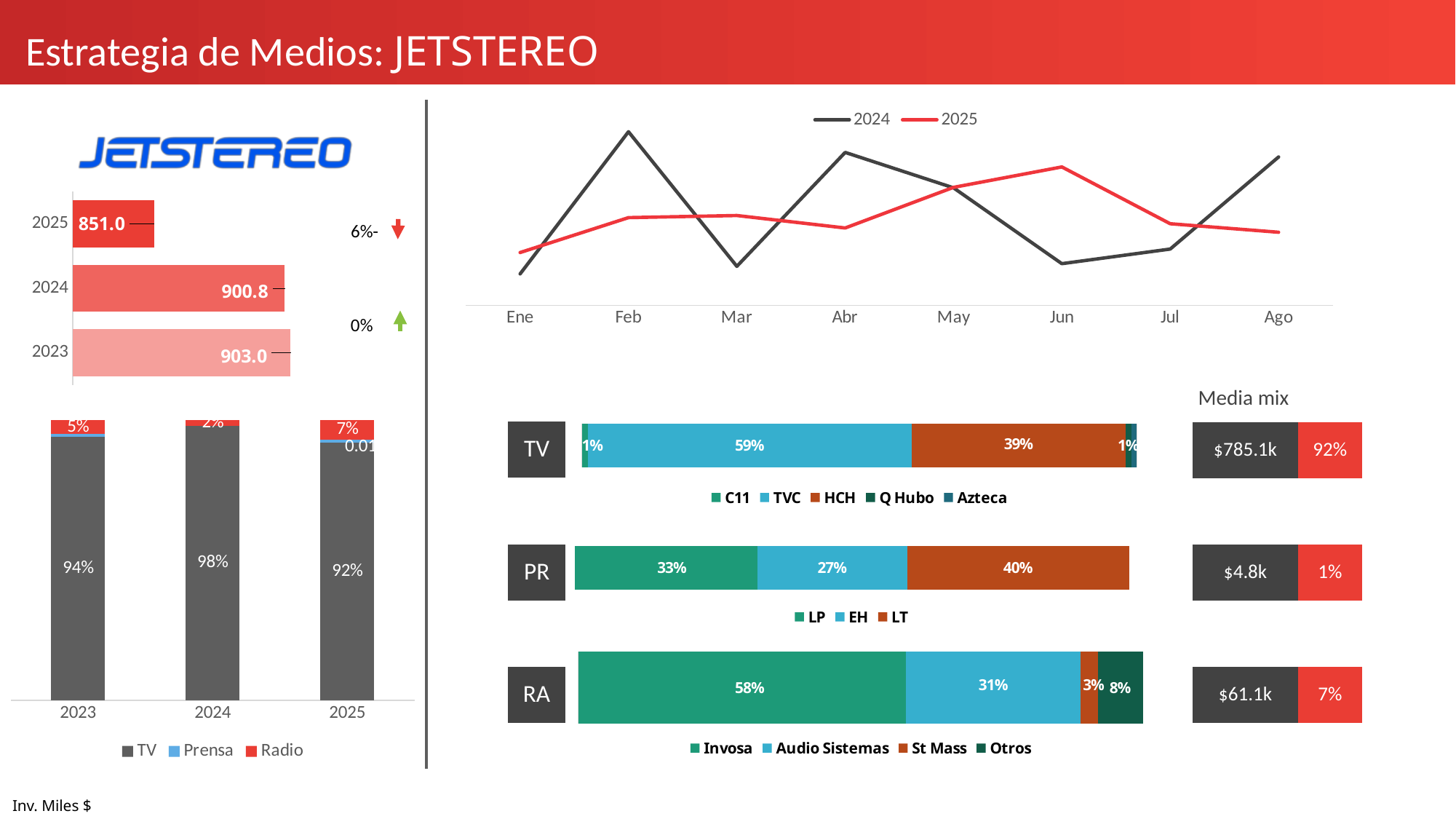
In the line chart at the top right, which series is higher in Feb, 2024 or 2025? 2024 In the horizontal bar chart of yearly investment on the left, what is the value for 2025? 851.0 In the horizontal bar chart of yearly investment on the left, what is the value for 2024? 900.8 In the horizontal bar chart of yearly investment on the left, what is the difference between the 2023 and 2025 values? 52.0 In the TV stacked bar, what is the share for TVC? 59% In the horizontal bar chart of yearly investment on the left, which year has the highest value? 2023 In the stacked bar chart by year at the bottom left, what is the Radio share for 2025? 7% In the RA stacked bar, what is the share for Audio Sistemas? 31% In the PR stacked bar, which outlet has the largest share? LT In the stacked bar chart by year at the bottom left, what is the TV share for 2024? 98% In the stacked bar chart by year at the bottom left, how many series does the legend list? 3 In the line chart at the top right, how many months are shown on the x axis? 8